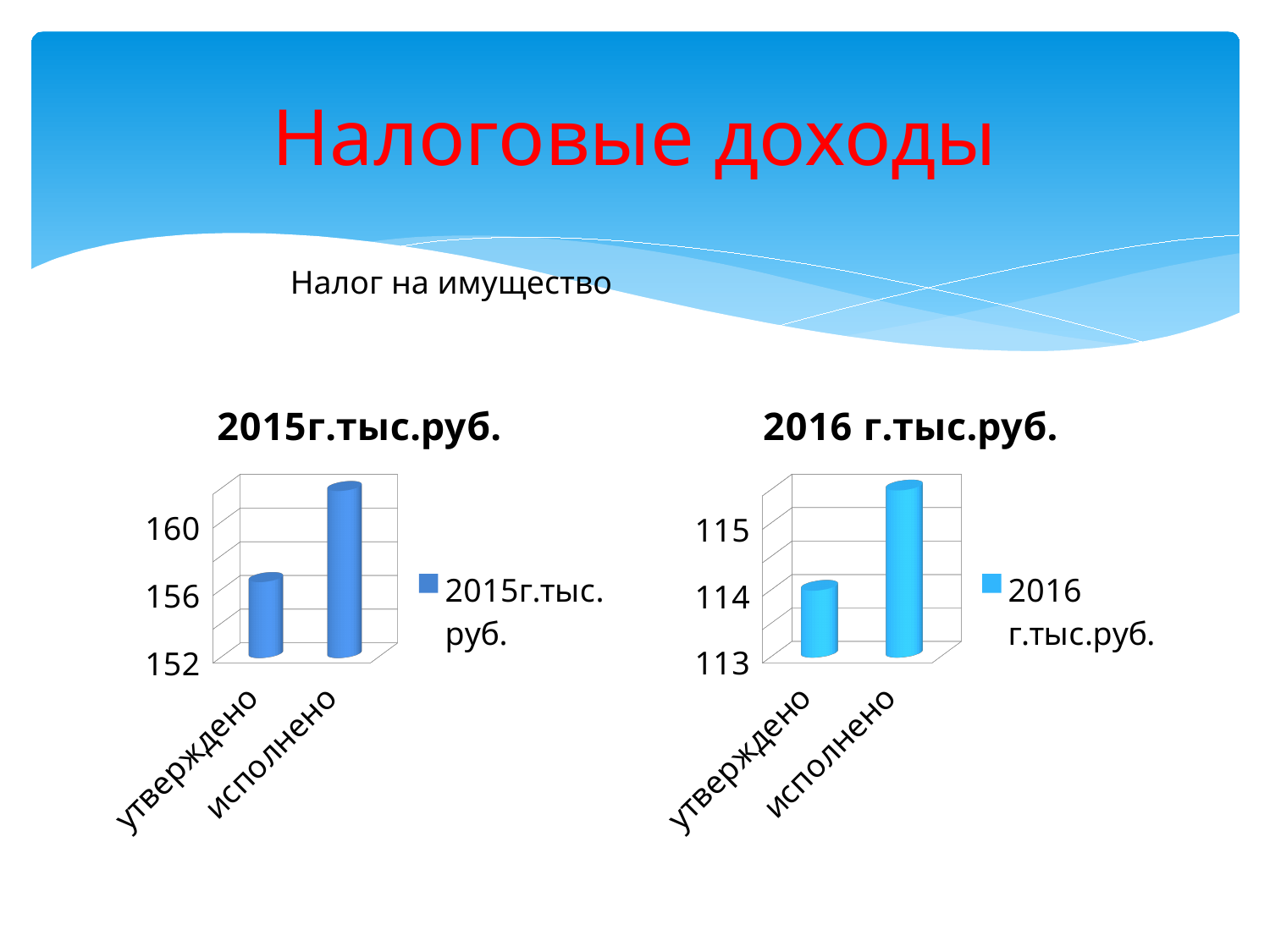
What kind of chart is the chart titled "2015г.тыс.руб."? bar chart In the chart titled "2015г.тыс.руб.", which category has the higher value? исполнено In the chart titled "2016 г.тыс.руб.", which category has the lower value? утверждено In the chart titled "2016 г.тыс.руб.", is the value for исполнено greater or less than 115? greater In the chart titled "2015г.тыс.руб.", is the value for утверждено greater or less than 160? less In the chart titled "2015г.тыс.руб.", is the value for утверждено larger or smaller than the value for исполнено? smaller In the chart titled "2015г.тыс.руб.", is the value for исполнено greater or less than 160? greater In the chart titled "2016 г.тыс.руб.", which category has the higher value? исполнено How many categories are shown in the chart titled "2016 г.тыс.руб."? 2 In the chart titled "2015г.тыс.руб.", which category has the lower value? утверждено How many series does the legend of the chart titled "2016 г.тыс.руб." list? 1